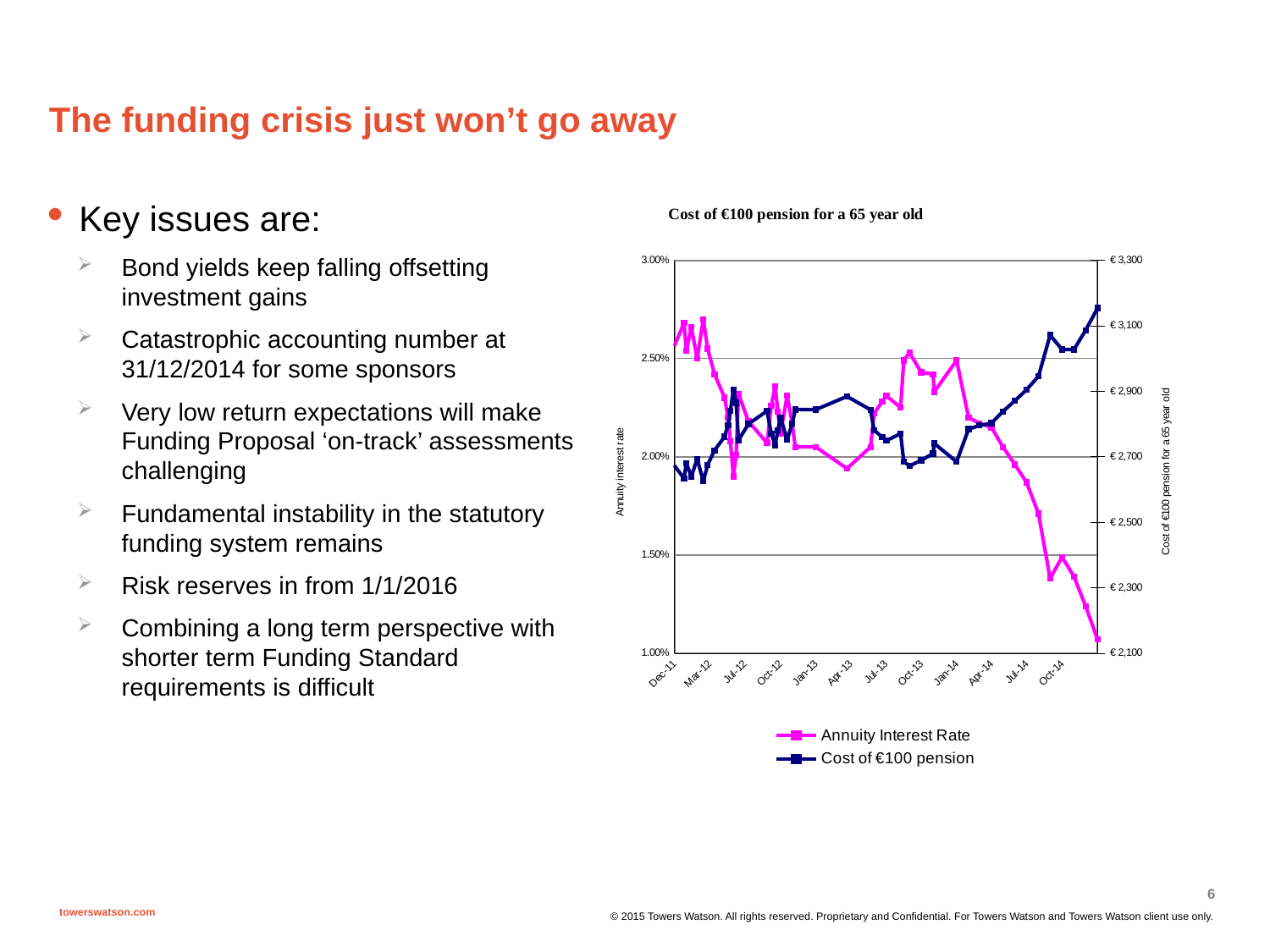
What kind of chart is shown on the slide? Line chart Is the Annuity Interest Rate at the last point on the chart greater or less than 1.50%? less Is the Cost of €100 pension around Oct-14 greater or less than €2,900? greater Does the Annuity Interest Rate series generally rise or fall from Dec-11 to the end of the chart? Fall Is the Cost of €100 pension at the last point on the chart greater or less than €3,100? greater Which colour is used for the Annuity Interest Rate series? Magenta (pink) Does the Cost of €100 pension series generally rise or fall from Dec-11 to the end of the chart? Rise What is the title of the chart? Cost of €100 pension for a 65 year old How many series does the chart's legend list? 2